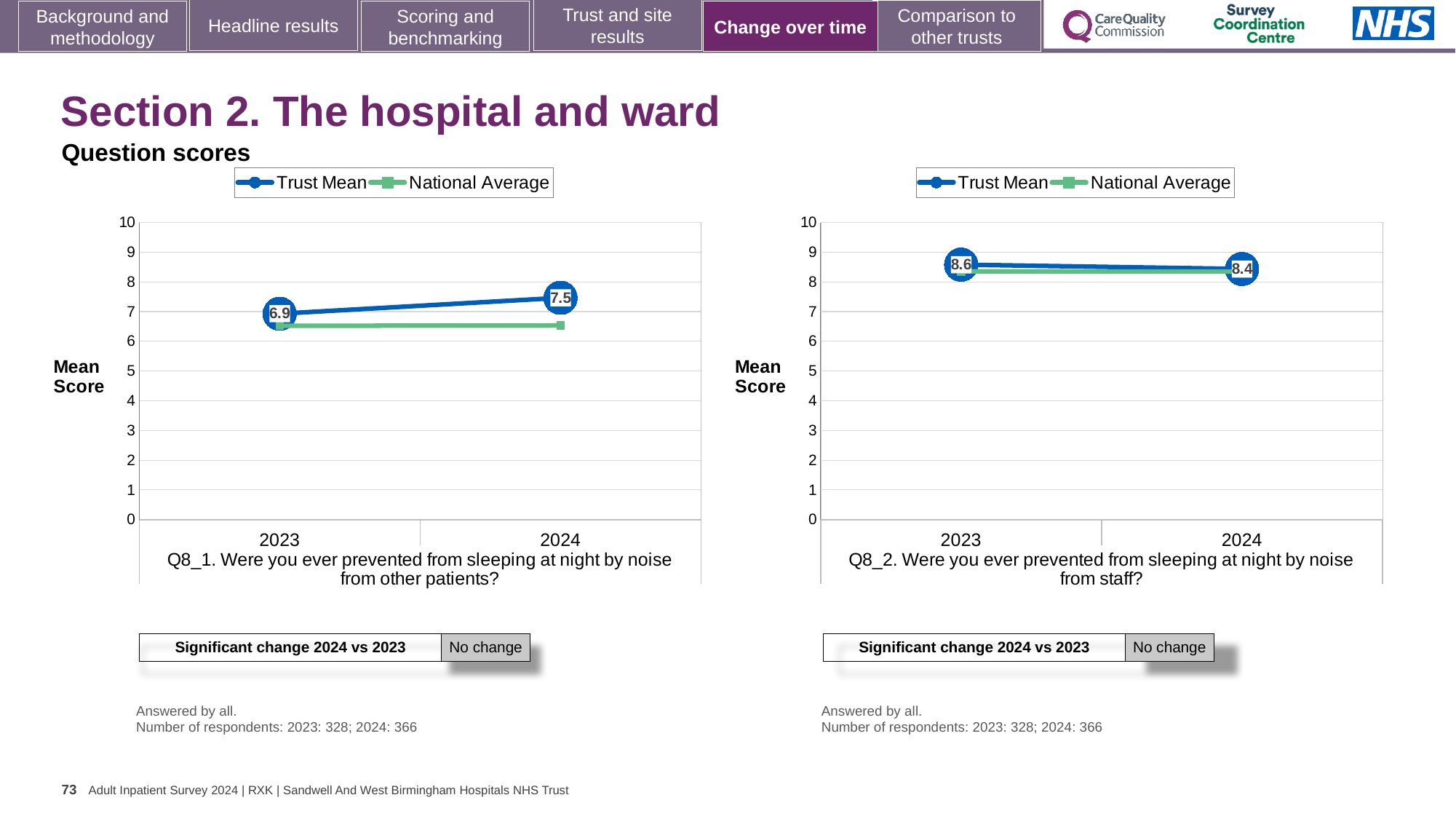
On the Q8_1 chart (left), by how much did the Trust Mean change from 2023 to 2024? 0.6 On the Q8_1 chart (left), what is the Trust Mean score for 2023? 6.9 On the Q8_2 chart (right), what is the difference between the Trust Mean in 2023 and 2024? 0.2 How many series does the legend of the Q8_2 chart (right) list? 2 On the Q8_1 chart (left), does the Trust Mean rise or fall from 2023 to 2024? rise What kind of chart is the Q8_1 chart on the left? line chart On the Q8_2 chart (right), what is the Trust Mean score for 2024? 8.4 On the Q8_1 chart (left), which is larger in 2024: the Trust Mean or the National Average? Trust Mean On the Q8_2 chart (right), what is the Trust Mean score for 2023? 8.6 On the Q8_1 chart (left), is the National Average value for 2024 greater or less than 7? less On the Q8_1 chart (left), what is the Trust Mean score for 2024? 7.5 On the Q8_2 chart (right), does the Trust Mean rise or fall from 2023 to 2024? fall